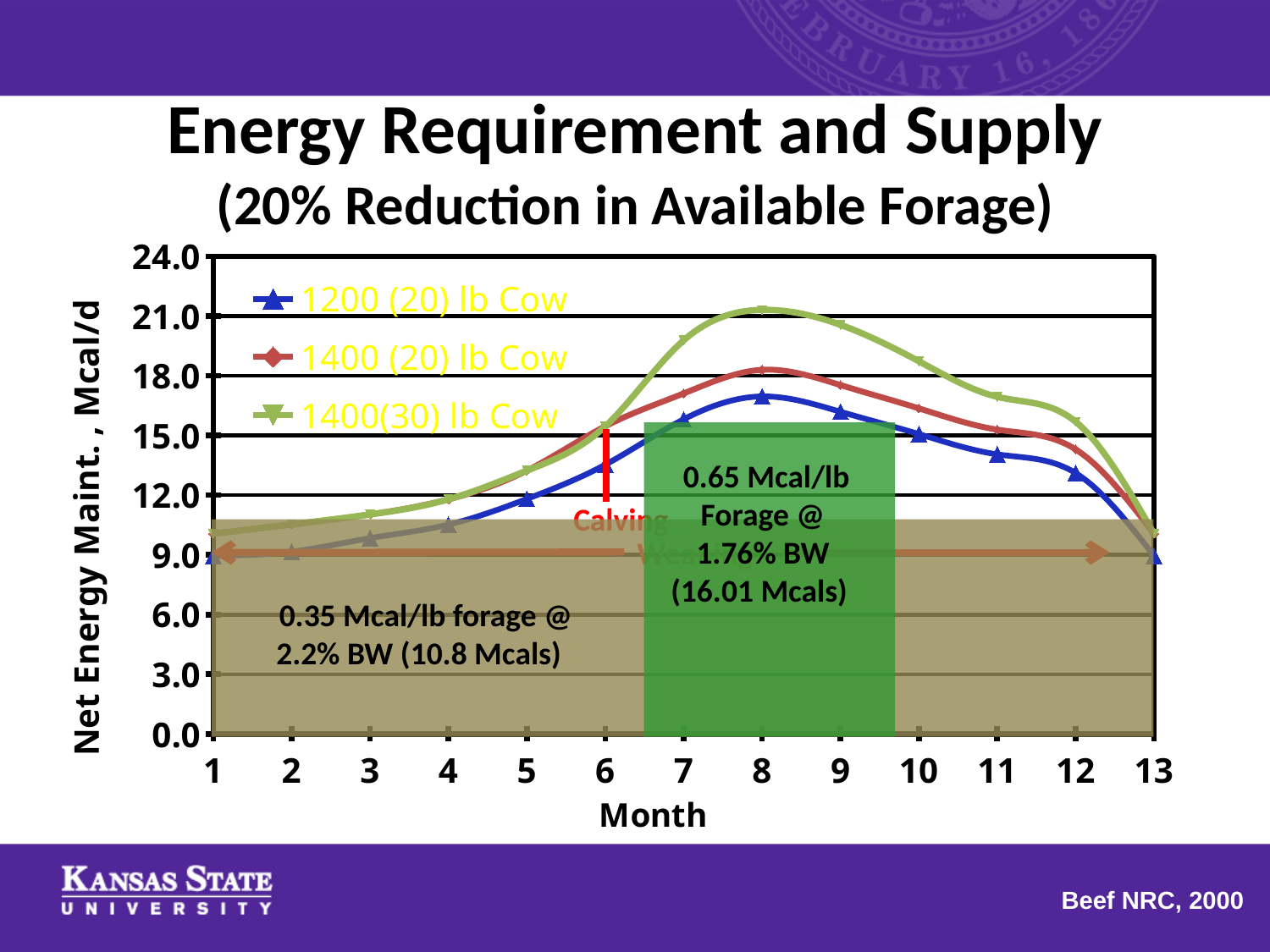
Which series has the lowest values around month 8? 1200 (20) lb Cow What is the title of the chart's y axis? Net Energy Maint., Mcal/d At month 8, which is larger: the value for the 1400 (20) lb Cow or the 1200 (20) lb Cow? 1400 (20) lb Cow What kind of chart is shown on the slide? line chart Do the values for the 1400(30) lb Cow rise or fall from month 8 to month 13? fall Is the value for the 1200 (20) lb Cow at month 8 greater or less than 18.0? less What colour is the line for the 1200 (20) lb Cow series? blue Is the value for the 1200 (20) lb Cow at month 2 greater or less than 12.0? less How many months are labelled along the x axis of the chart? 13 Is the value for the 1400(30) lb Cow at month 8 greater or less than 18.0? greater How many series does the chart legend list? 3 Which series reaches the highest value on the chart? 1400(30) lb Cow